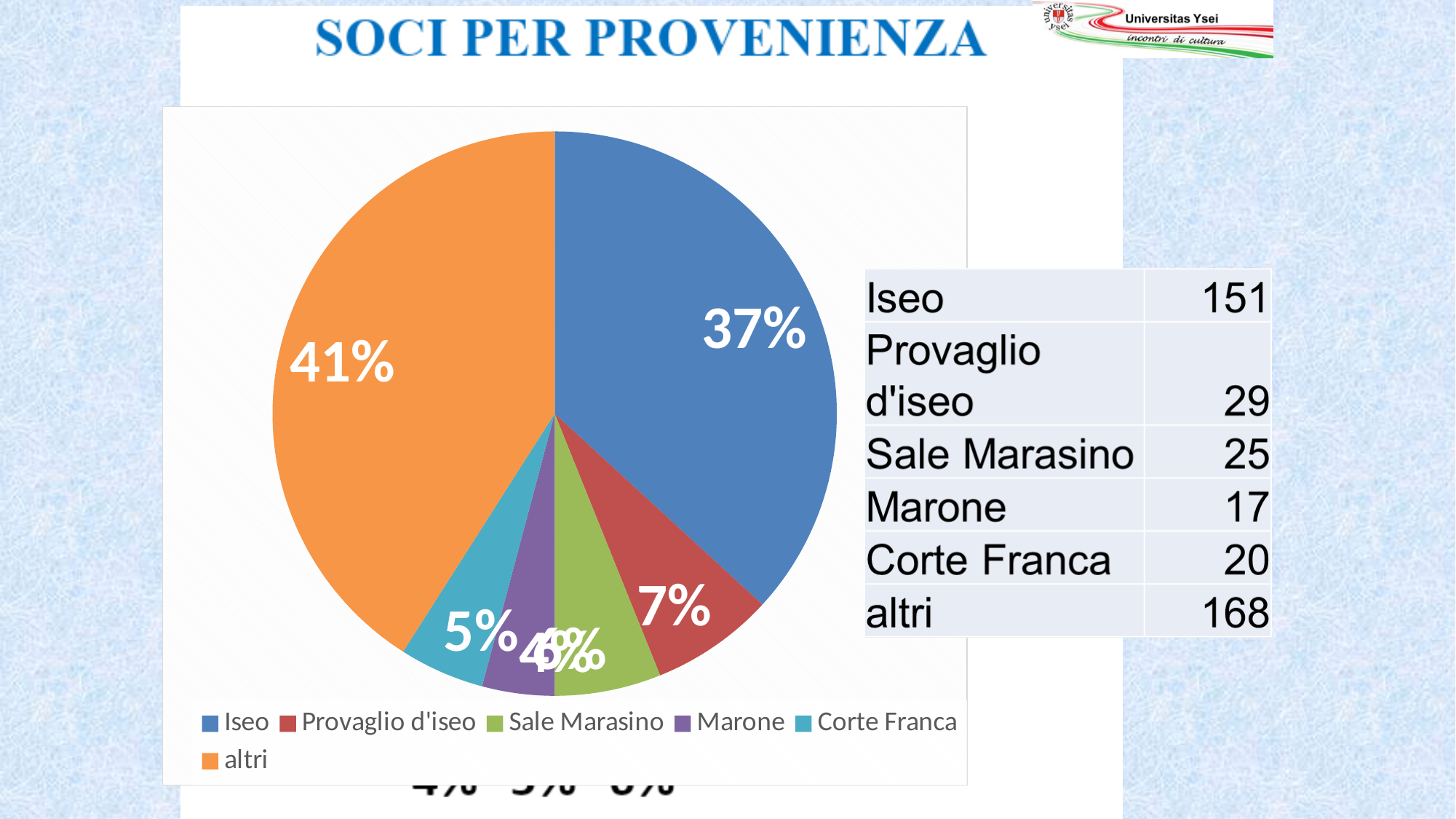
According to the table next to the chart, which category has the fewest soci? Marone Which is larger, the slice for Iseo or the slice for altri? altri What share of the pie does Corte Franca represent? 5% Which category has the largest slice of the pie? altri What share of the pie does altri represent? 41% What kind of chart is shown on the slide? pie chart What share of the pie does Provaglio d'iseo represent? 7% How many categories does the legend of the pie chart list? 6 By how many percentage points does the altri slice exceed the Iseo slice? 4 According to the table next to the chart, how many soci come from Iseo? 151 What is the title of the chart? SOCI PER PROVENIENZA